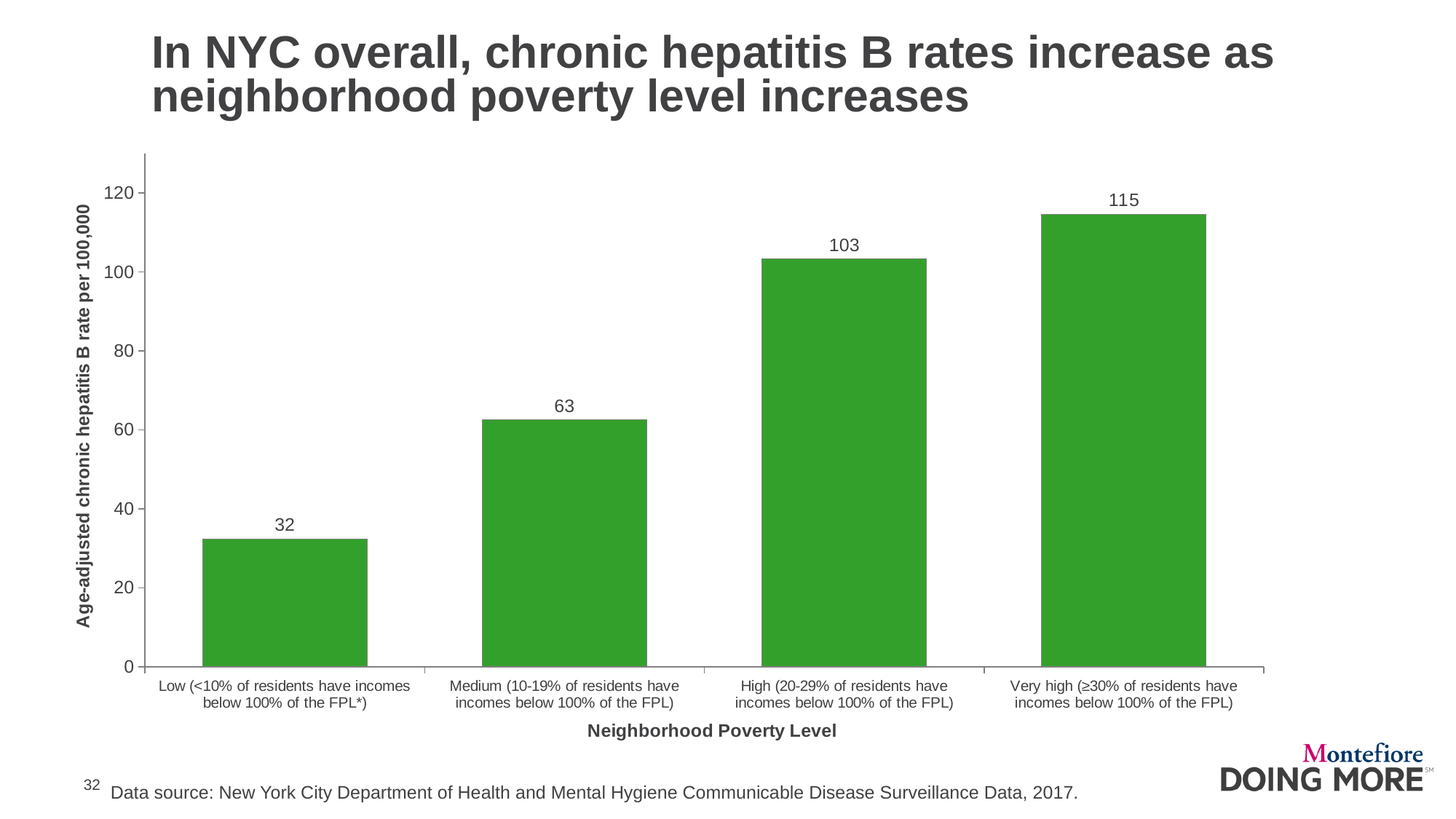
What is the age-adjusted chronic hepatitis B rate per 100,000 for the Low neighborhood poverty level? 32 What is the age-adjusted chronic hepatitis B rate per 100,000 for the High neighborhood poverty level? 103 What is the difference in chronic hepatitis B rate between the High and Medium poverty levels? 40 How many neighborhood poverty level categories are shown in the chart? 4 Do the chronic hepatitis B rates rise or fall as neighborhood poverty level increases from Low to Very high? Rise Which neighborhood poverty level has the lowest chronic hepatitis B rate? Low What is the difference in chronic hepatitis B rate between the Very high and Low poverty levels? 83 What kind of chart is shown on the slide? Bar chart What is the age-adjusted chronic hepatitis B rate per 100,000 for the Very high neighborhood poverty level? 115 Which neighborhood poverty level has the highest chronic hepatitis B rate? Very high What is the age-adjusted chronic hepatitis B rate per 100,000 for the Medium neighborhood poverty level? 63 Which has a higher chronic hepatitis B rate, the Medium or the High poverty level? High